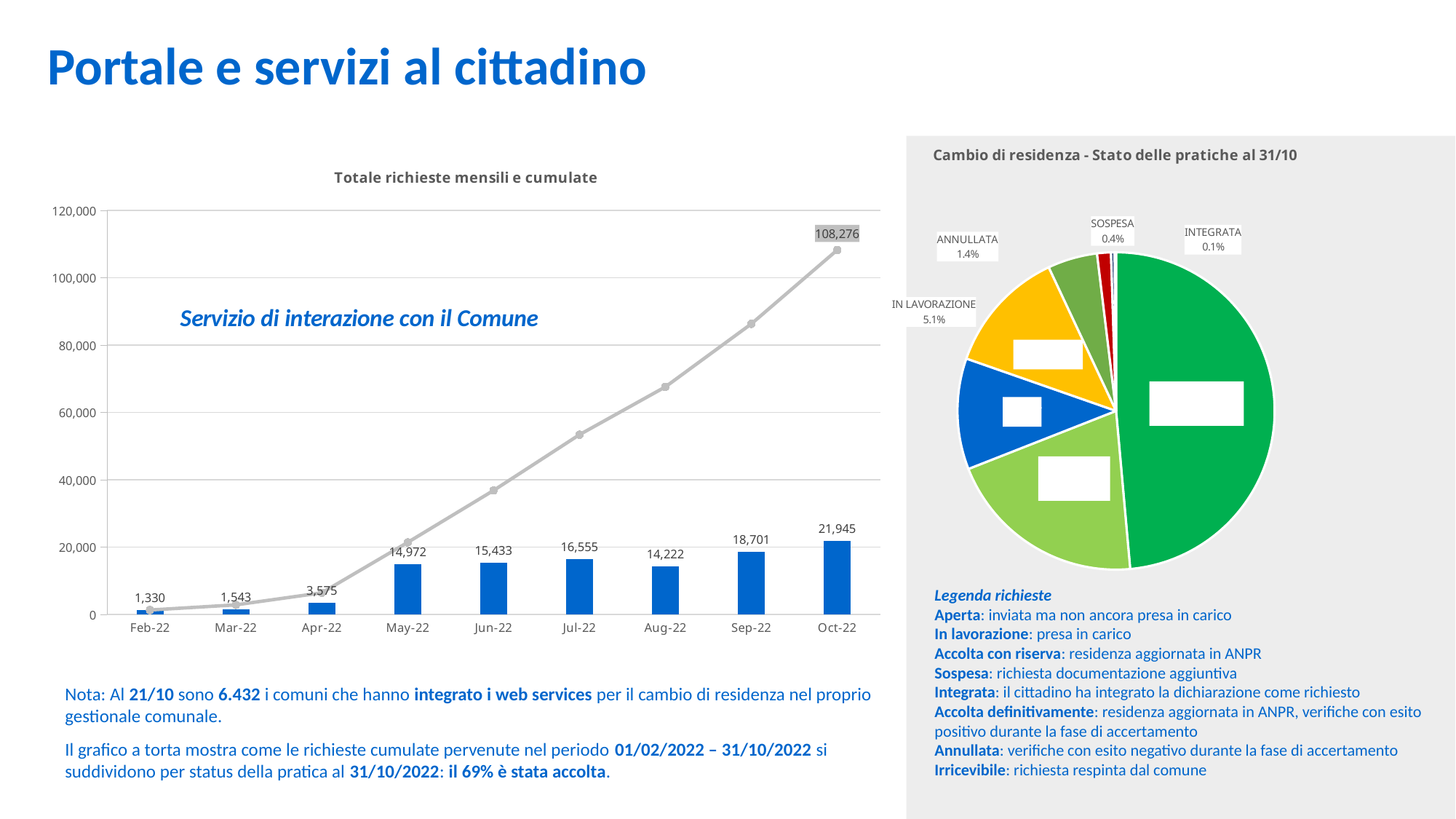
In the chart 'Totale richieste mensili e cumulate', which month has the lowest monthly bar? Feb-22 In the chart 'Totale richieste mensili e cumulate', how many months are shown on the x axis? 9 In the chart 'Totale richieste mensili e cumulate', what is the monthly value for May-22? 14,972 In the chart 'Totale richieste mensili e cumulate', is the cumulative line value at Aug-22 greater or less than 60,000? greater In the chart 'Totale richieste mensili e cumulate', does the cumulative line rise or fall from Feb-22 to Oct-22? rises In the chart 'Totale richieste mensili e cumulate', what is the cumulative value labelled at Oct-22? 108,276 In the pie chart 'Cambio di residenza - Stato delle pratiche al 31/10', what share is labelled for ANNULLATA? 1.4% In the pie chart 'Cambio di residenza - Stato delle pratiche al 31/10', what share is labelled for IN LAVORAZIONE? 5.1% In the chart 'Totale richieste mensili e cumulate', which month has the highest monthly bar? Oct-22 In the chart 'Totale richieste mensili e cumulate', what is the difference between the monthly values for Oct-22 and Sep-22? 3,244 In the chart 'Totale richieste mensili e cumulate', what is the monthly value for Oct-22? 21,945 In the chart 'Totale richieste mensili e cumulate', which month has the larger monthly value, Jul-22 or Aug-22? Jul-22